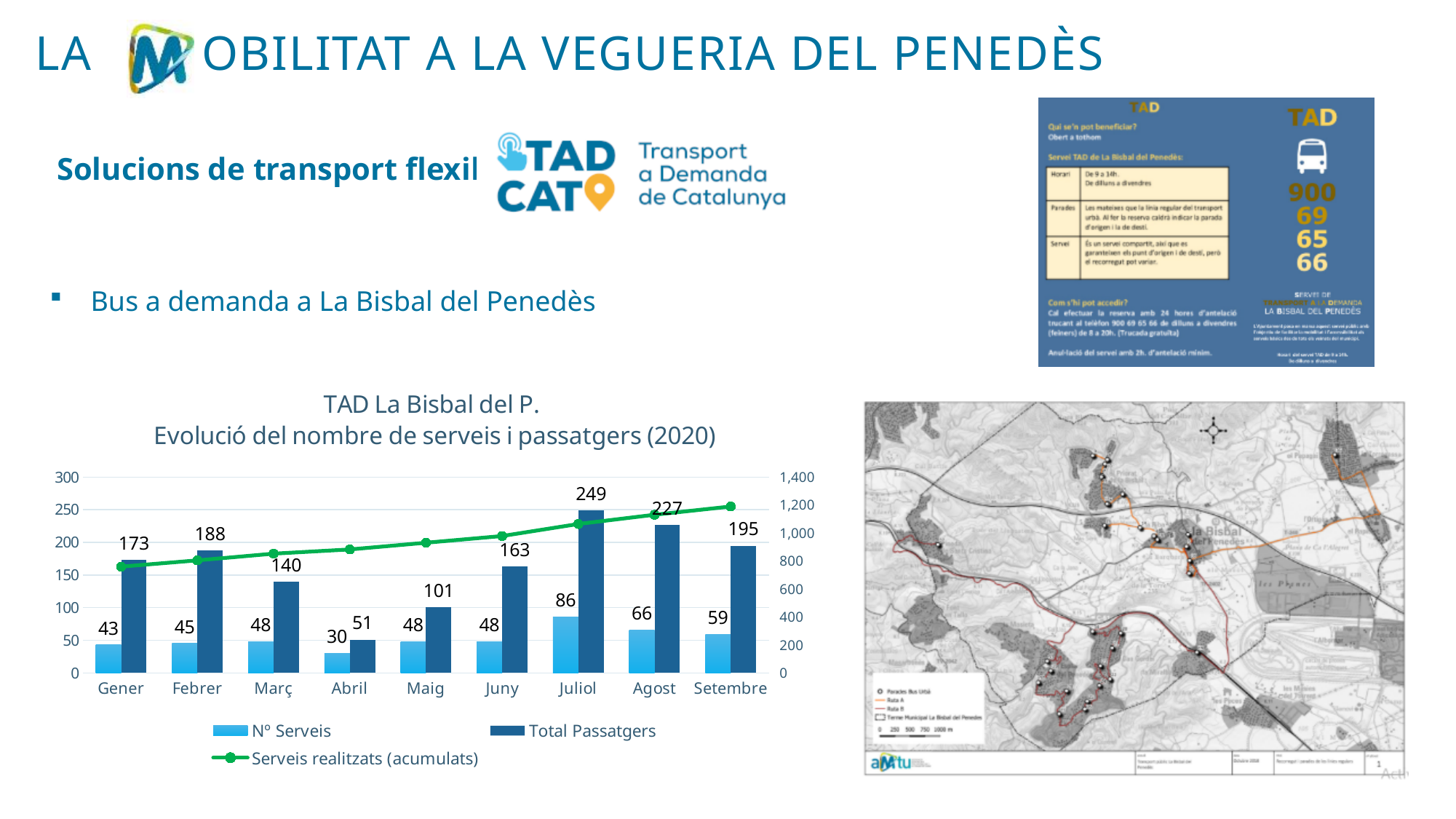
Is the Serveis realitzats (acumulats) value for Gener greater or less than 600 on the right-hand axis? greater How many months are shown on the x axis of the chart? 9 Does the Serveis realitzats (acumulats) line rise or fall from Gener to Setembre? rise What is the title of the chart? TAD La Bisbal del P. Evolució del nombre de serveis i passatgers (2020) What is the difference between the Total Passatgers values for Agost and Setembre? 32 Which is larger, the Total Passatgers value for Gener or for Març? Gener How many series does the chart legend list? 3 What kind of chart is used to show Nº Serveis and Total Passatgers? bar chart Which month has the highest Total Passatgers value? Juliol What is the Nº Serveis value for Abril? 30 What is the Total Passatgers value for Juliol? 249 Which month has the lowest Nº Serveis value? Abril